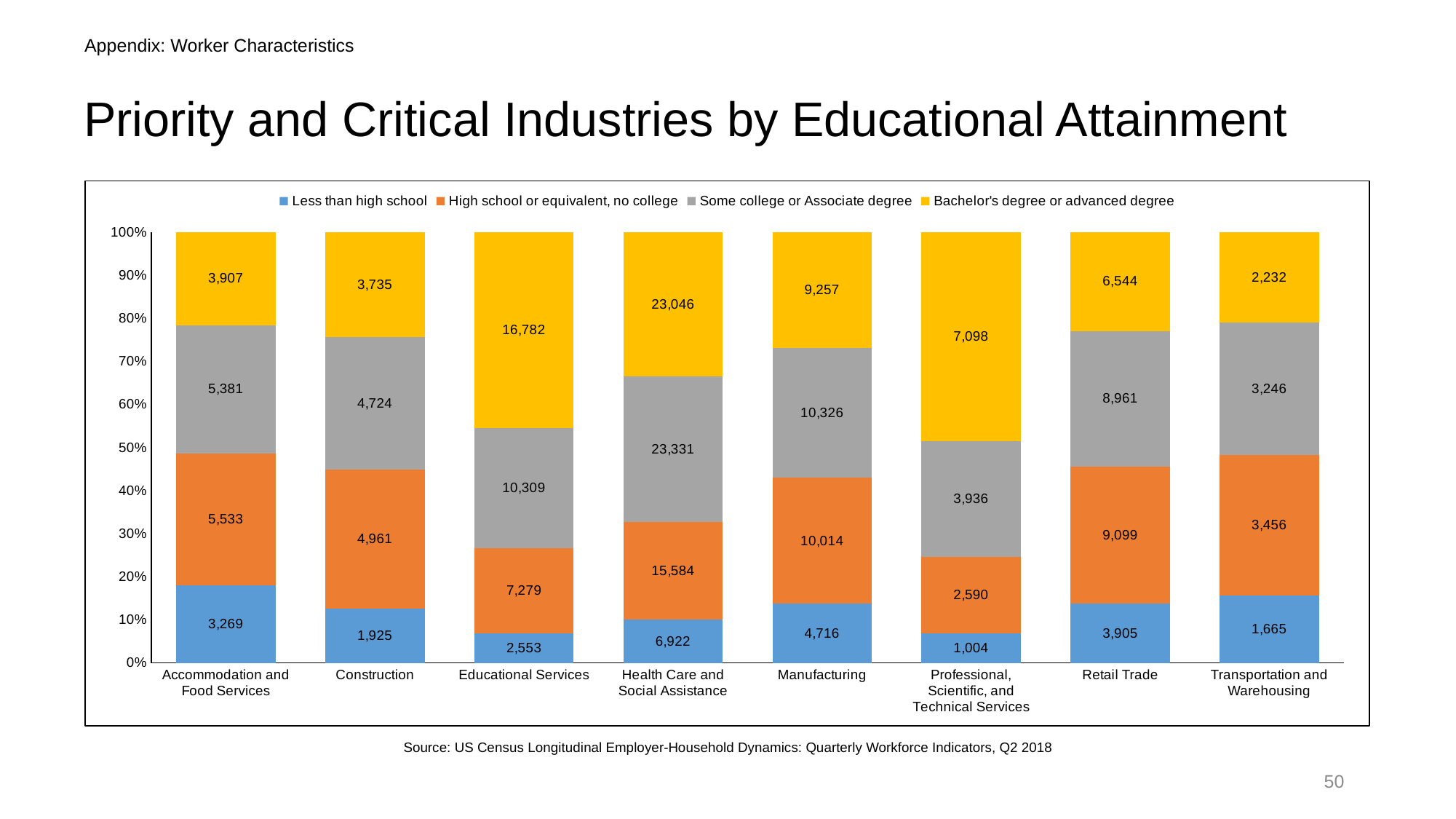
What is the total of all four segments in the Accommodation and Food Services bar? 18,090 Which industry has the lowest value for 'Less than high school'? Professional, Scientific, and Technical Services What is the difference between the 'High school or equivalent, no college' value and the 'Some college or Associate degree' value in Retail Trade? 138 How many series does the chart's legend list? 4 What is the value for 'Bachelor's degree or advanced degree' in Professional, Scientific, and Technical Services? 7,098 Which industry has the highest value for 'Less than high school'? Health Care and Social Assistance Is the share of the Educational Services bar taken by 'Bachelor's degree or advanced degree' greater or less than 40%? greater In Manufacturing, which is larger: the 'Some college or Associate degree' value or the 'High school or equivalent, no college' value? Some college or Associate degree What kind of chart is shown on the slide? Stacked bar chart What is the value for 'Less than high school' in Health Care and Social Assistance? 6,922 What is the value for 'Some college or Associate degree' in Retail Trade? 8,961 How many industries are shown on the x axis of the chart? 8